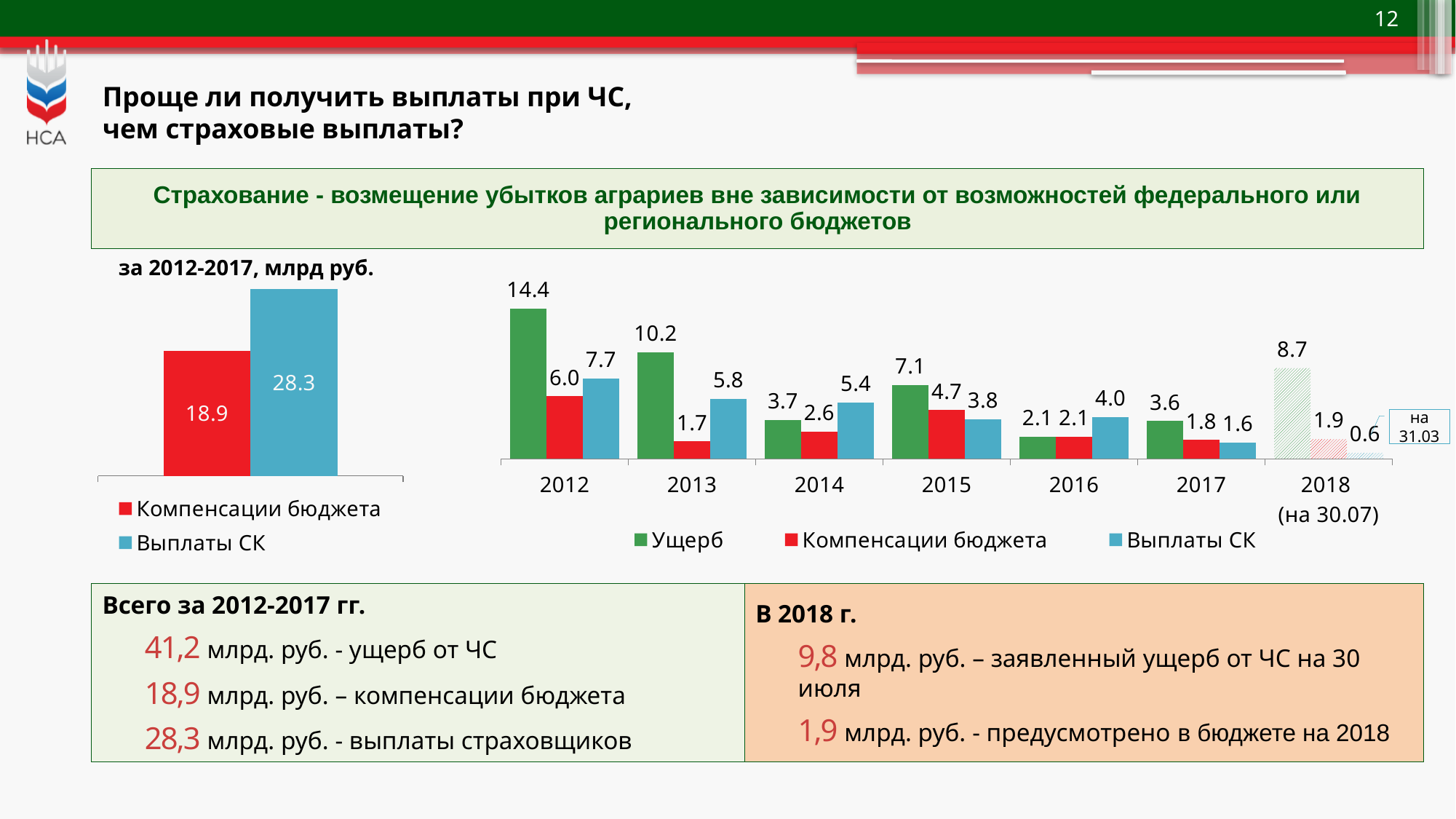
In the left chart (за 2012-2017, млрд руб.), what is the value for Компенсации бюджета? 18.9 In the right chart by year, what is the value of Компенсации бюджета for 2013? 1.7 In the left chart (за 2012-2017, млрд руб.), how many series does the legend list? 2 In the left chart (за 2012-2017, млрд руб.), what is the value for Выплаты СК? 28.3 In the right chart by year, what is the difference between Ущерб and Выплаты СК in 2015? 3.3 In the right chart by year, what is the value of Выплаты СК for 2014? 5.4 In the right chart by year, which year has the highest Ущерб value? 2012 In the right chart by year, which is larger in 2016: Компенсации бюджета or Выплаты СК? Выплаты СК In the right chart by year, what is the value of Ущерб for 2012? 14.4 In the left chart (за 2012-2017, млрд руб.), what is the difference between Выплаты СК and Компенсации бюджета? 9.4 In the right chart by year, which year has the lowest Выплаты СК value? 2018 In the right chart by year, how many years are shown on the x axis? 7